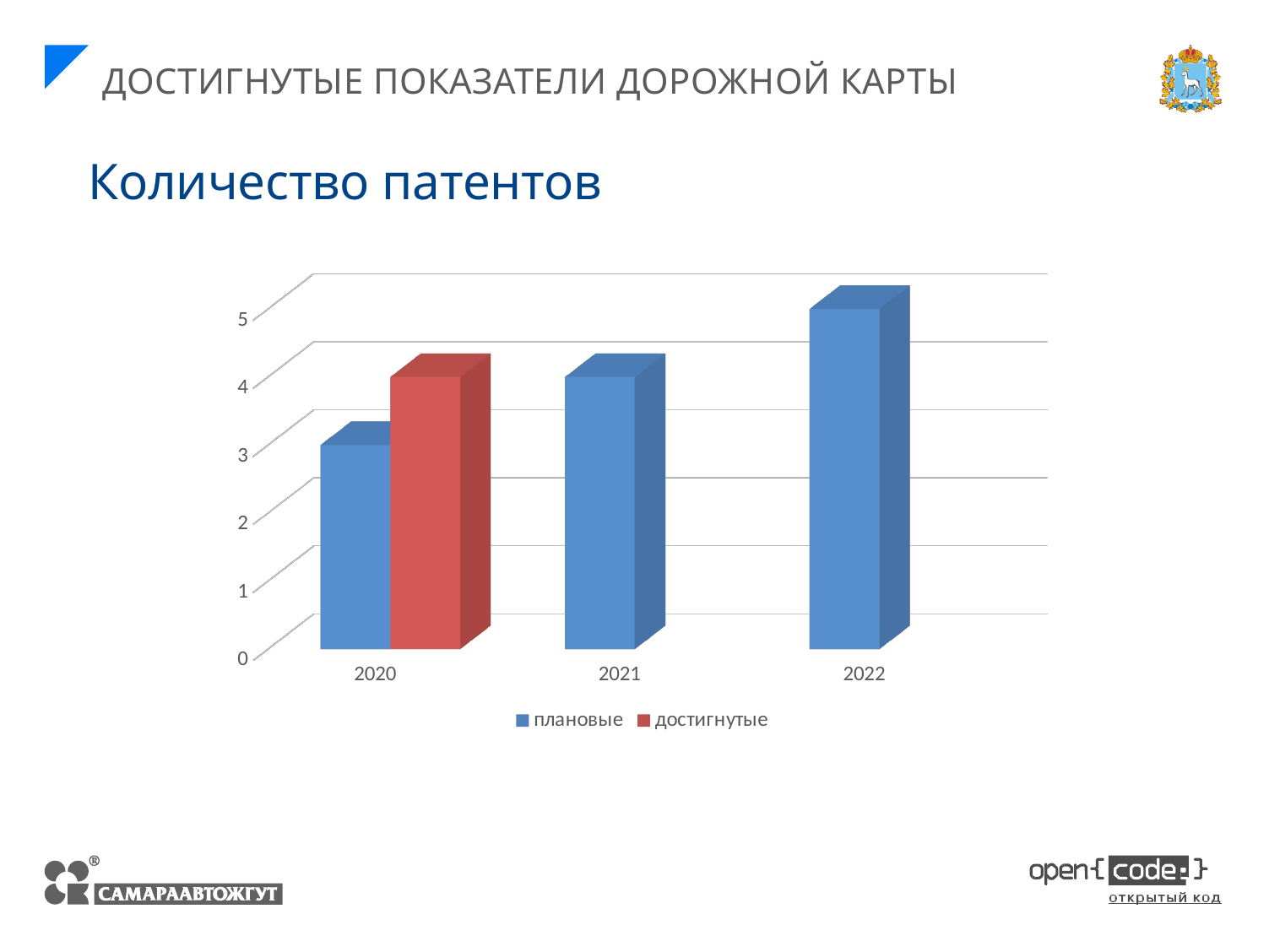
Do the плановые values rise or fall from 2020 to 2022? rise What is the плановые value for 2020? 3 Is the плановые value for 2022 greater or less than 4? greater How many series does the legend list? 2 How many years are shown on the x axis? 3 What is the достигнутые value for 2020? 4 Which year has the highest плановые value? 2022 Which year has the lowest плановые value? 2020 For 2020, which is larger: плановые or достигнутые? достигнутые What kind of chart is shown on the slide? bar chart What is the title of the chart? Количество патентов What is the плановые value for 2022? 5